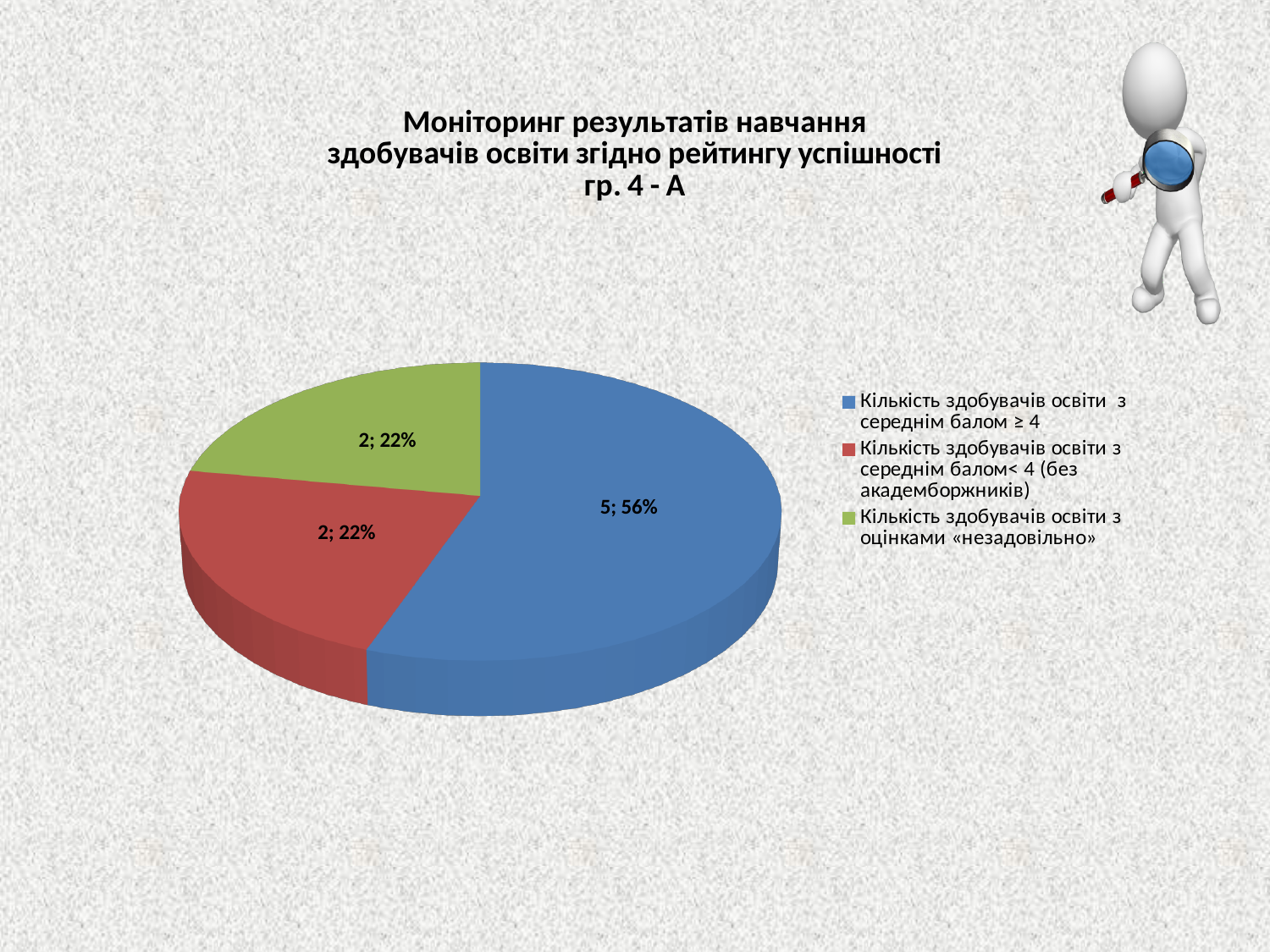
What share of the pie does "Кількість здобувачів освіти з оцінками «незадовільно»" take? 22% What share of the pie does "Кількість здобувачів освіти з середнім балом ≥ 4" take? 56% What is the difference between the value for "Кількість здобувачів освіти з середнім балом ≥ 4" and the value for "Кількість здобувачів освіти з оцінками «незадовільно»"? 3 What is the value for "Кількість здобувачів освіти з середнім балом ≥ 4"? 5 What kind of chart is shown on the slide? pie chart What colour is the slice for "Кількість здобувачів освіти з оцінками «незадовільно»"? green What is the value for "Кількість здобувачів освіти з середнім балом< 4 (без академборжників)"? 2 How many entries does the legend list? 3 How many slices does the pie chart have? 3 What is the value for "Кількість здобувачів освіти з оцінками «незадовільно»"? 2 Which is larger: the value for "Кількість здобувачів освіти з середнім балом ≥ 4" or the value for "Кількість здобувачів освіти з середнім балом< 4 (без академборжників)"? Кількість здобувачів освіти з середнім балом ≥ 4 Which category has the largest slice of the pie? Кількість здобувачів освіти з середнім балом ≥ 4